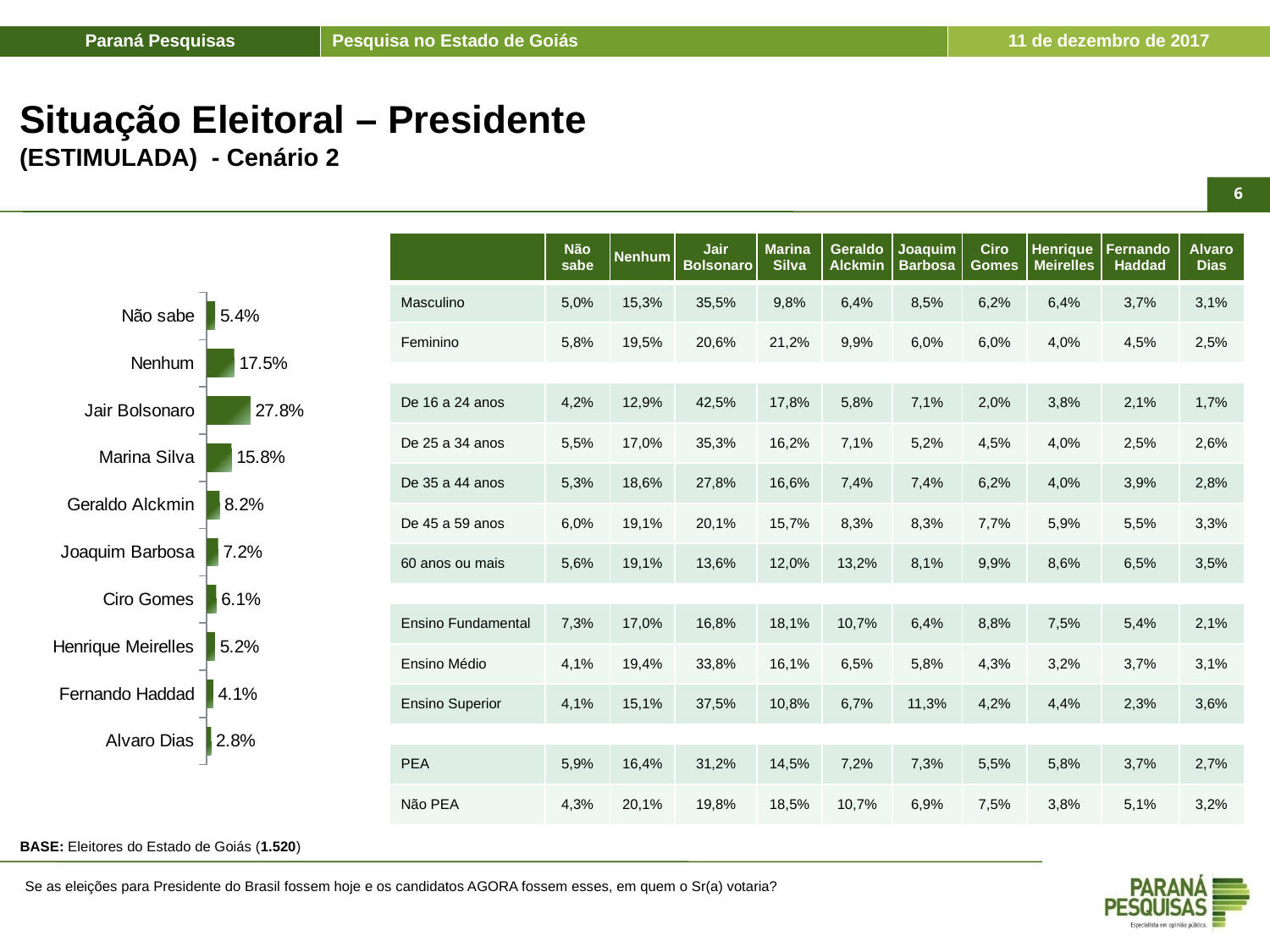
What value does the bar chart show for Nenhum? 17.5% In the bar chart, what is the difference between the values for Geraldo Alckmin and Joaquim Barbosa? 1.0% What type of chart is shown on the left of the slide? Bar chart How many categories are shown in the bar chart? 10 What value does the bar chart show for Jair Bolsonaro? 27.8% In the bar chart, what is the difference between the values for Jair Bolsonaro and Marina Silva? 12.0% In the bar chart, which is larger: the value for Nenhum or the value for Marina Silva? Nenhum Which category has the lowest value in the bar chart? Alvaro Dias What value does the bar chart show for Henrique Meirelles? 5.2% In the bar chart, which is larger: the value for Ciro Gomes or the value for Fernando Haddad? Ciro Gomes Which category has the highest value in the bar chart? Jair Bolsonaro What value does the bar chart show for Marina Silva? 15.8%